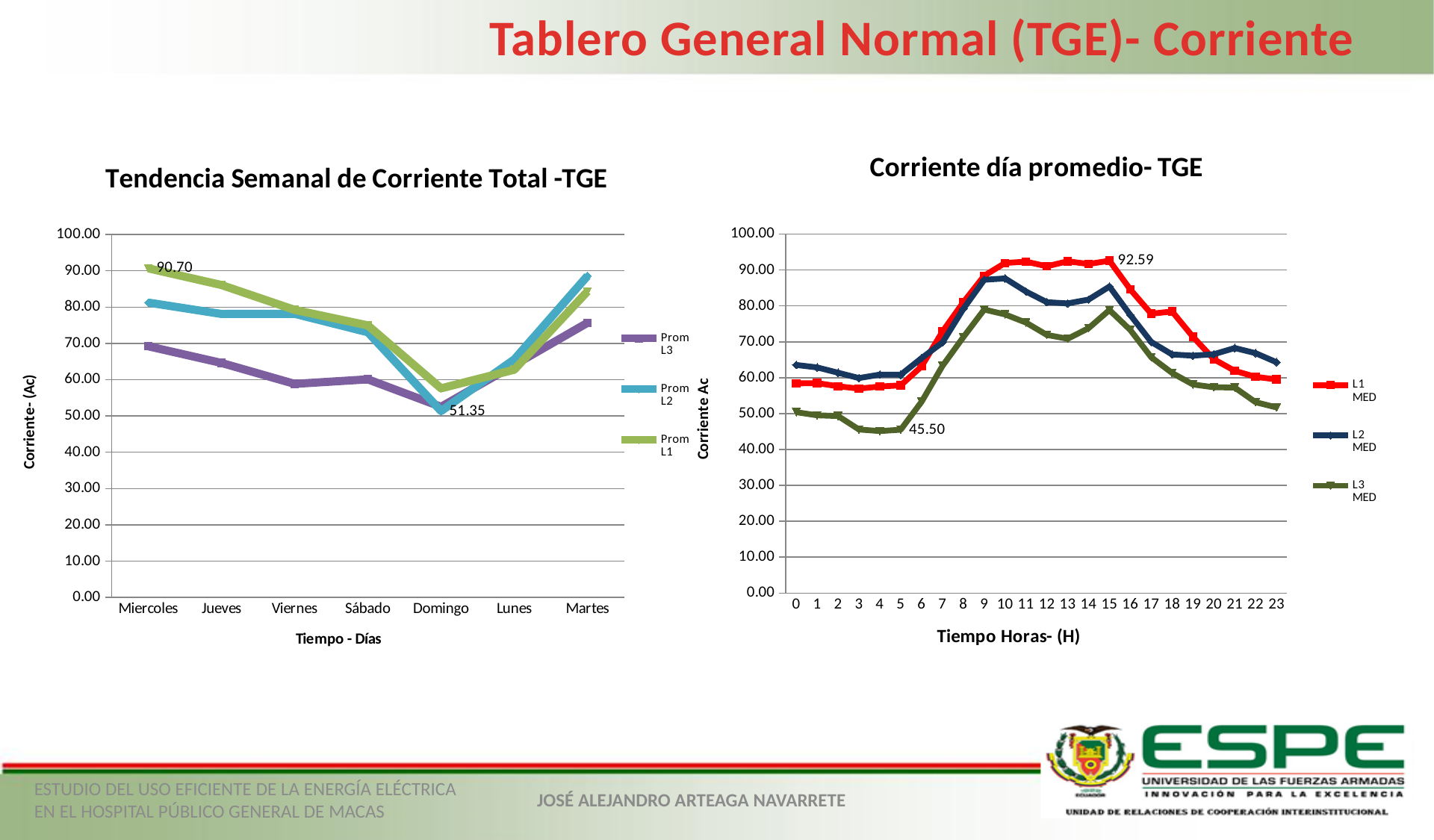
In the 'Corriente día promedio- TGE' chart, how many series does the legend list? 3 In the 'Corriente día promedio- TGE' chart, how many hour points are shown on the x axis? 24 In the 'Corriente día promedio- TGE' chart, what is the value of L1 MED at hour 15? 92.59 In the 'Tendencia Semanal de Corriente Total -TGE' chart, what is the value of Prom L1 on Miercoles? 90.70 What kind of chart is the 'Tendencia Semanal de Corriente Total -TGE' chart? line chart In the 'Tendencia Semanal de Corriente Total -TGE' chart, how many series does the legend list? 3 In the 'Tendencia Semanal de Corriente Total -TGE' chart, what is the value of Prom L2 on Domingo? 51.35 In the 'Tendencia Semanal de Corriente Total -TGE' chart, on which day is Prom L2 lowest? Domingo In the 'Tendencia Semanal de Corriente Total -TGE' chart, is the value for Prom L3 on Miercoles greater or less than 60.00? greater In the 'Corriente día promedio- TGE' chart, which series is larger at hour 9, L1 MED or L3 MED? L1 MED In the 'Tendencia Semanal de Corriente Total -TGE' chart, how many days are shown on the x axis? 7